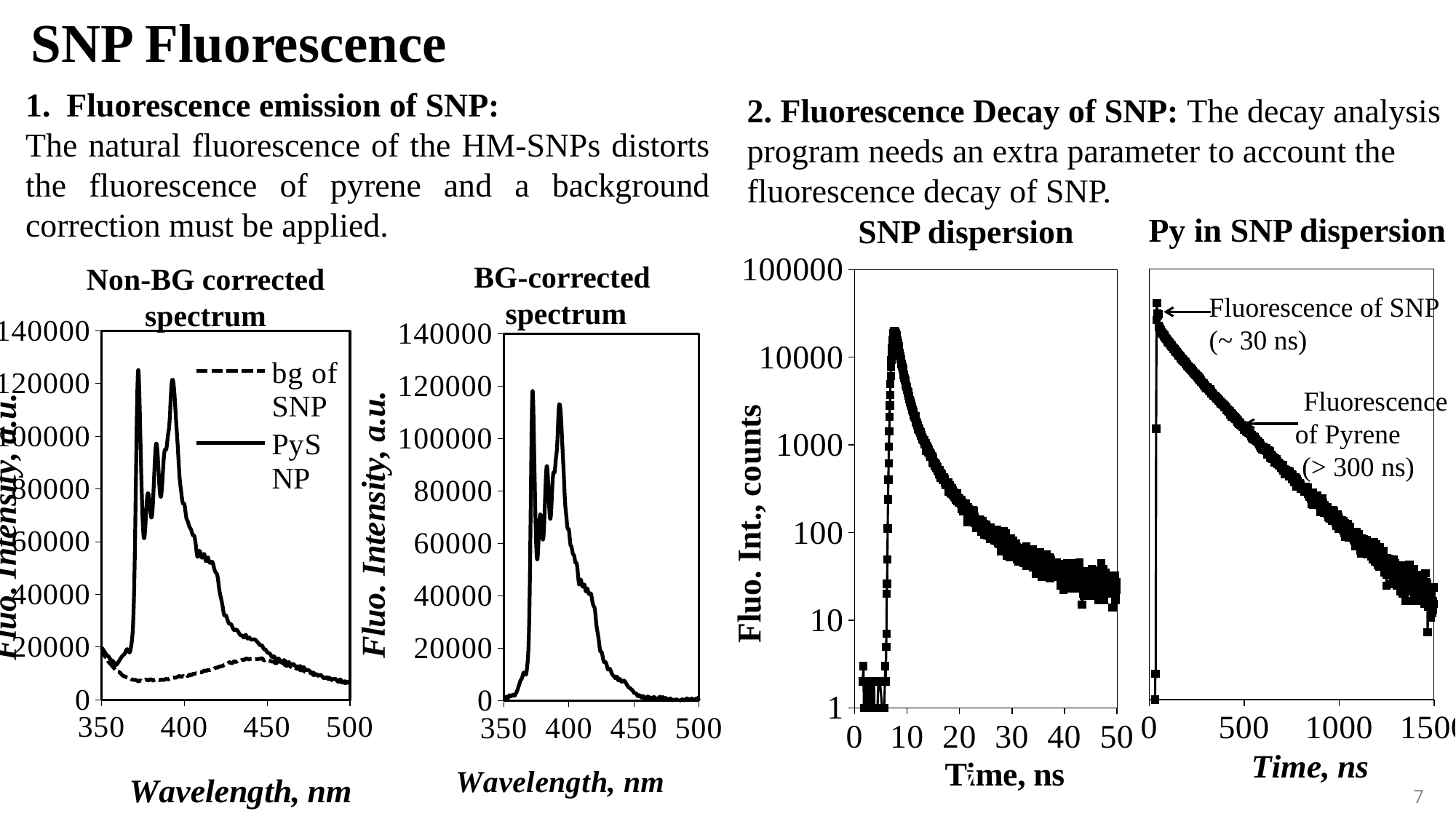
In the 'BG-corrected spectrum' chart, is the value at 500 nm greater or less than 20000? less What is the y-axis label of the 'SNP dispersion' chart? Fluo. Int., counts In the 'Non-BG corrected spectrum' chart, which series is drawn with a dashed line? bg of SNP In the 'BG-corrected spectrum' chart, is the highest value greater or less than 100000? greater In the 'Non-BG corrected spectrum' chart, is the peak value of the PySNP series greater or less than 100000? greater How many series does the legend of the 'Non-BG corrected spectrum' chart list? 2 In the 'Py in SNP dispersion' chart, do the values rise or fall along the x axis after the initial peak? fall What type of chart is the 'Non-BG corrected spectrum'? line chart